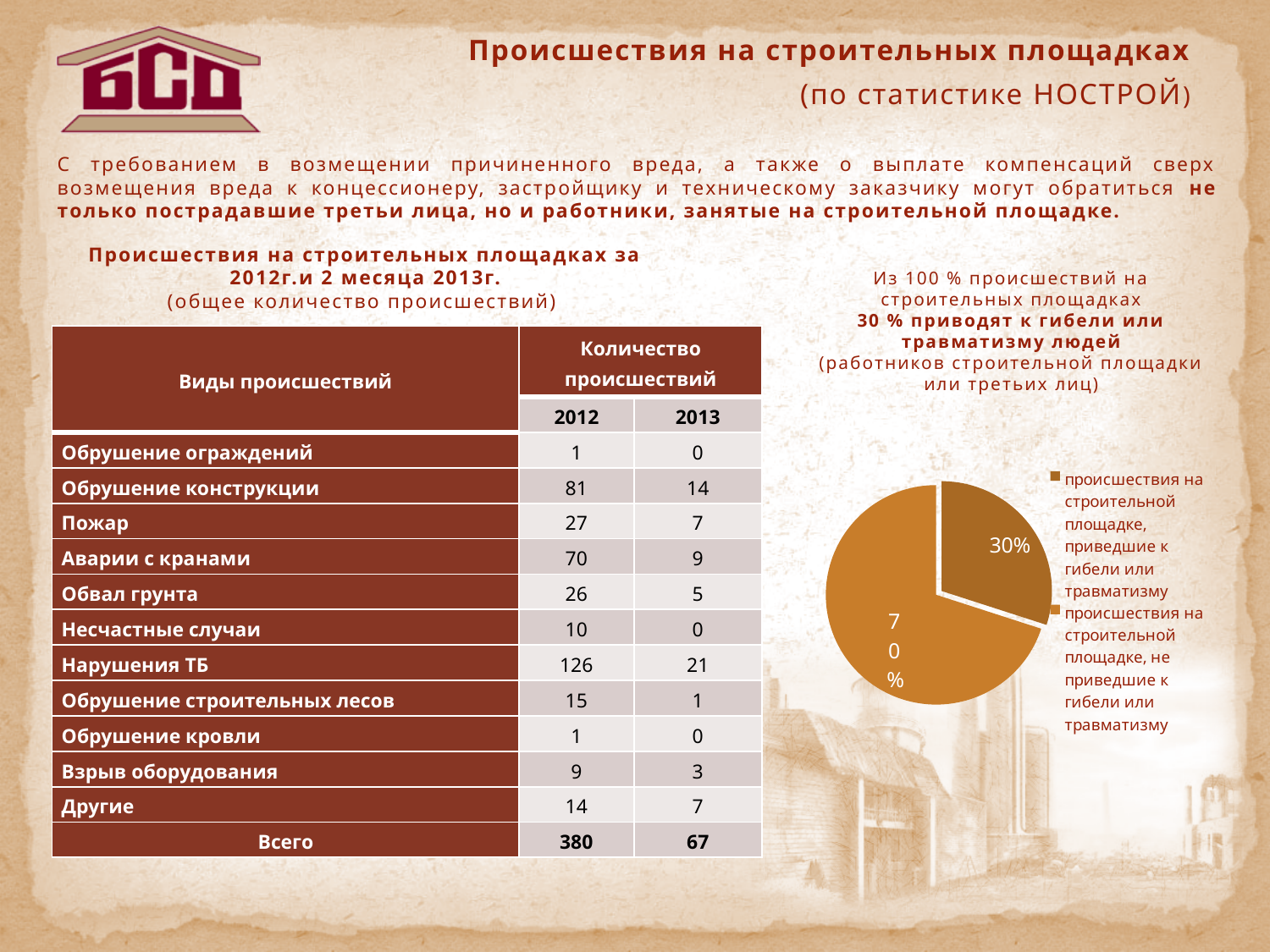
Which slice of the pie chart is the smallest? происшествия на строительной площадке, приведшие к гибели или травматизму How many entries does the legend of the pie chart list? 2 In the pie chart, what share is shown for incidents on construction sites that led to death or injury (происшествия, приведшие к гибели или травматизму)? 30% What colour is the slice for incidents leading to death or injury in the pie chart? dark brown In the pie chart, what is the difference in percentage points between the slice for incidents not leading to death or injury and the slice for incidents leading to death or injury? 40 percentage points Is the share of incidents leading to death or injury in the pie chart greater or less than 50%? less Which slice of the pie chart is the largest? происшествия на строительной площадке, не приведшие к гибели или травматизму What kind of chart is shown on the right side of the slide? pie chart How many slices does the pie chart have? 2 In the pie chart, which is larger: the share of incidents leading to death or injury, or the share of incidents not leading to death or injury? incidents not leading to death or injury (70%) In the pie chart, what share is shown for incidents on construction sites that did not lead to death or injury (происшествия, не приведшие к гибели или травматизму)? 70%